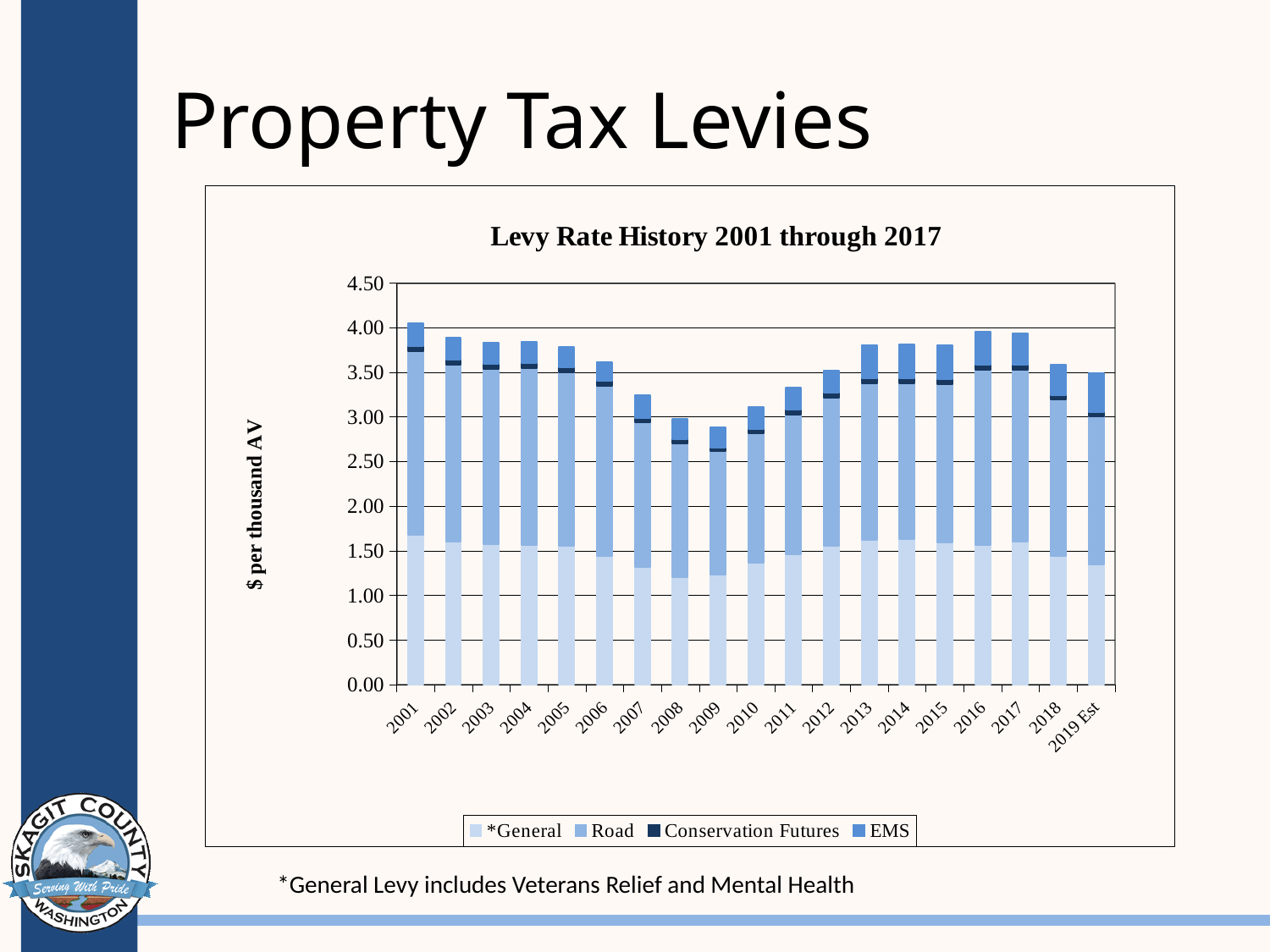
Do the total levy rates rise or fall from 2001 to 2009? fall How many years (categories) are shown along the x axis? 19 Is the total levy rate for 2016 greater or less than 4.00? less Which year has a larger total levy rate, 2001 or 2009? 2001 What is the label of the y axis? $ per thousand AV Which year has the lowest total levy rate? 2009 Is the total levy rate for 2001 greater or less than 4.00? greater What kind of chart is shown on the slide? Stacked bar chart What is the title of the chart? Levy Rate History 2001 through 2017 Which year has the highest total levy rate? 2001 How many series does the chart's legend list? 4 Is the total levy rate for 2009 greater or less than 3.00? less